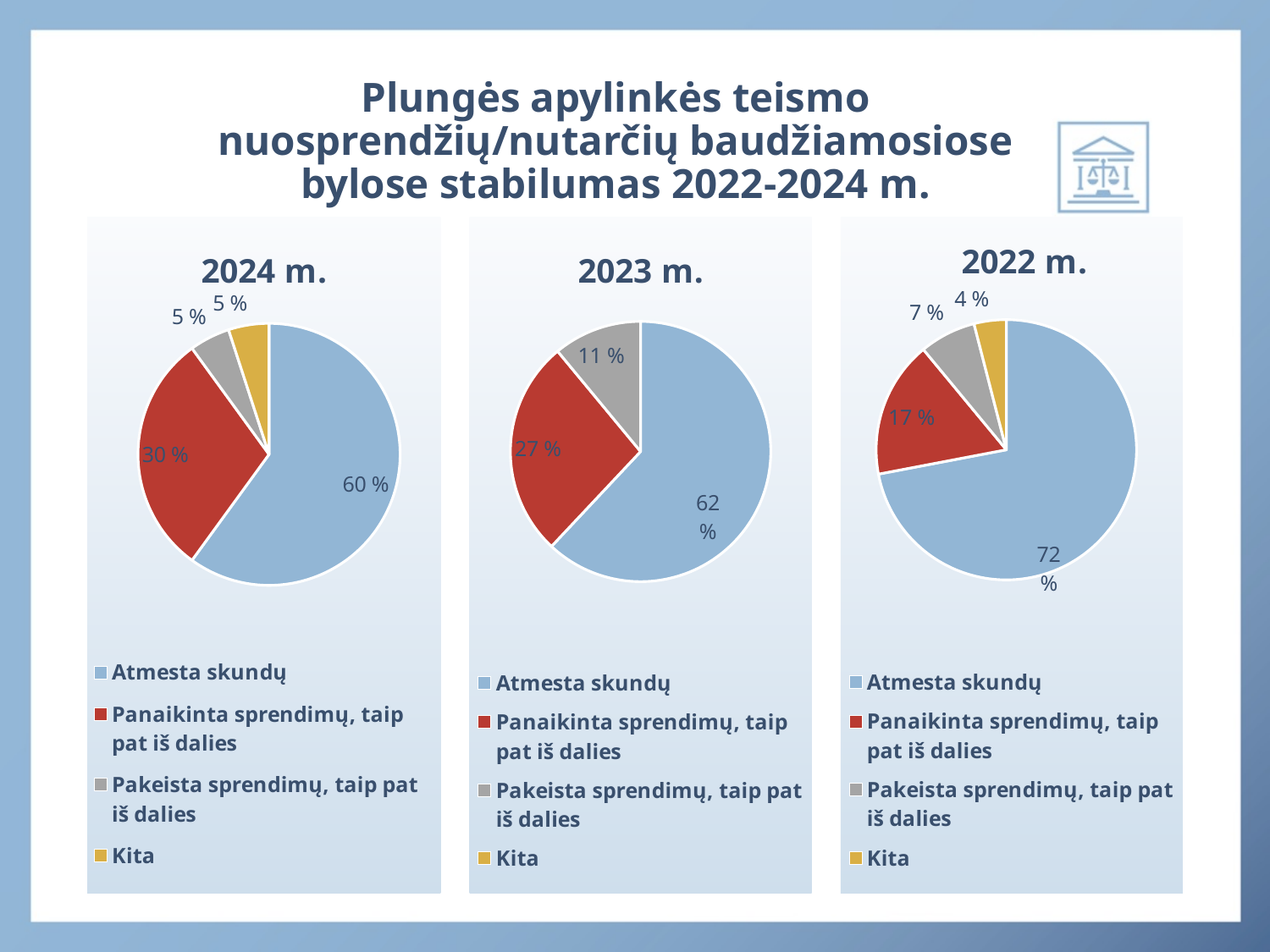
How many entries does the legend of the 2024 m. chart list? 4 In the 2022 m. pie chart, which category has the largest slice? Atmesta skundų Which is larger: the Atmesta skundų share in the 2022 m. chart or in the 2023 m. chart? 2022 m. In the 2024 m. pie chart, what share is labelled for Atmesta skundų? 60 % What type of chart is used for the 2023 m. data? Pie chart In the 2024 m. pie chart, what is the difference between the Atmesta skundų share and the Panaikinta sprendimų, taip pat iš dalies share? 30 % In the 2022 m. pie chart, which category has the smallest slice? Kita In the 2022 m. pie chart, what share is labelled for Atmesta skundų? 72 % In the 2022 m. pie chart, what share is labelled for Kita? 4 % In the 2024 m. pie chart, what share is labelled for Panaikinta sprendimų, taip pat iš dalies? 30 % In the 2023 m. pie chart, what share is labelled for Panaikinta sprendimų, taip pat iš dalies? 27 % In the 2023 m. pie chart, what share is labelled for Pakeista sprendimų, taip pat iš dalies? 11 %